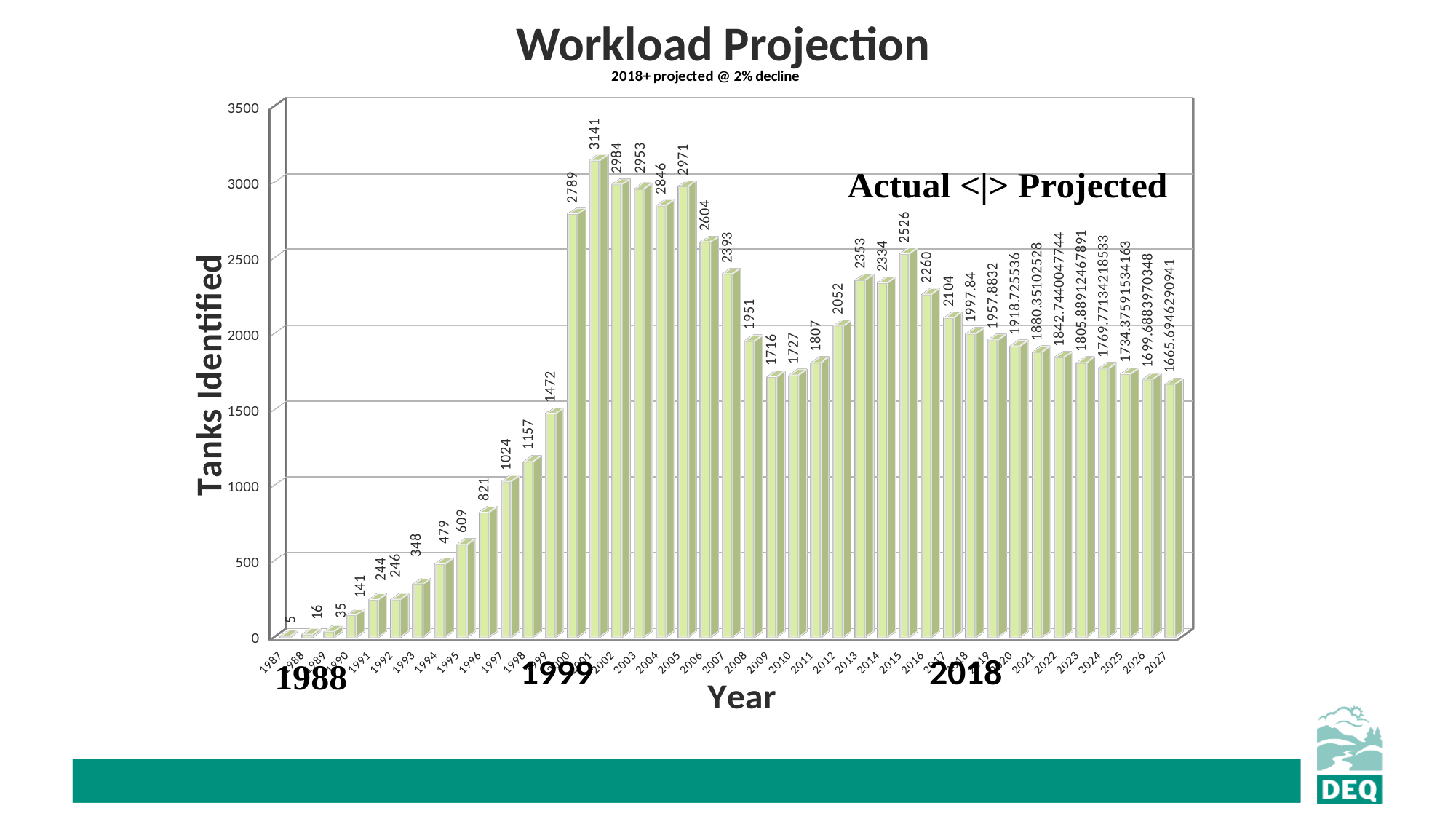
Which year has the lowest number of tanks identified? 1987 Is the value for 2012 greater or less than 2500? less What is the value for 1999? 1472 What is the title of the y axis? Tanks Identified How many years are plotted on the chart? 41 What is the value for 2001? 3141 Do the values rise or fall from 2018 to 2027? fall Which is larger, the value for 2005 or the value for 2004? 2005 What is the value for 2015? 2526 What is the difference between the values for 2001 and 2000? 352 Which year has the highest number of tanks identified? 2001 What kind of chart is shown? bar chart